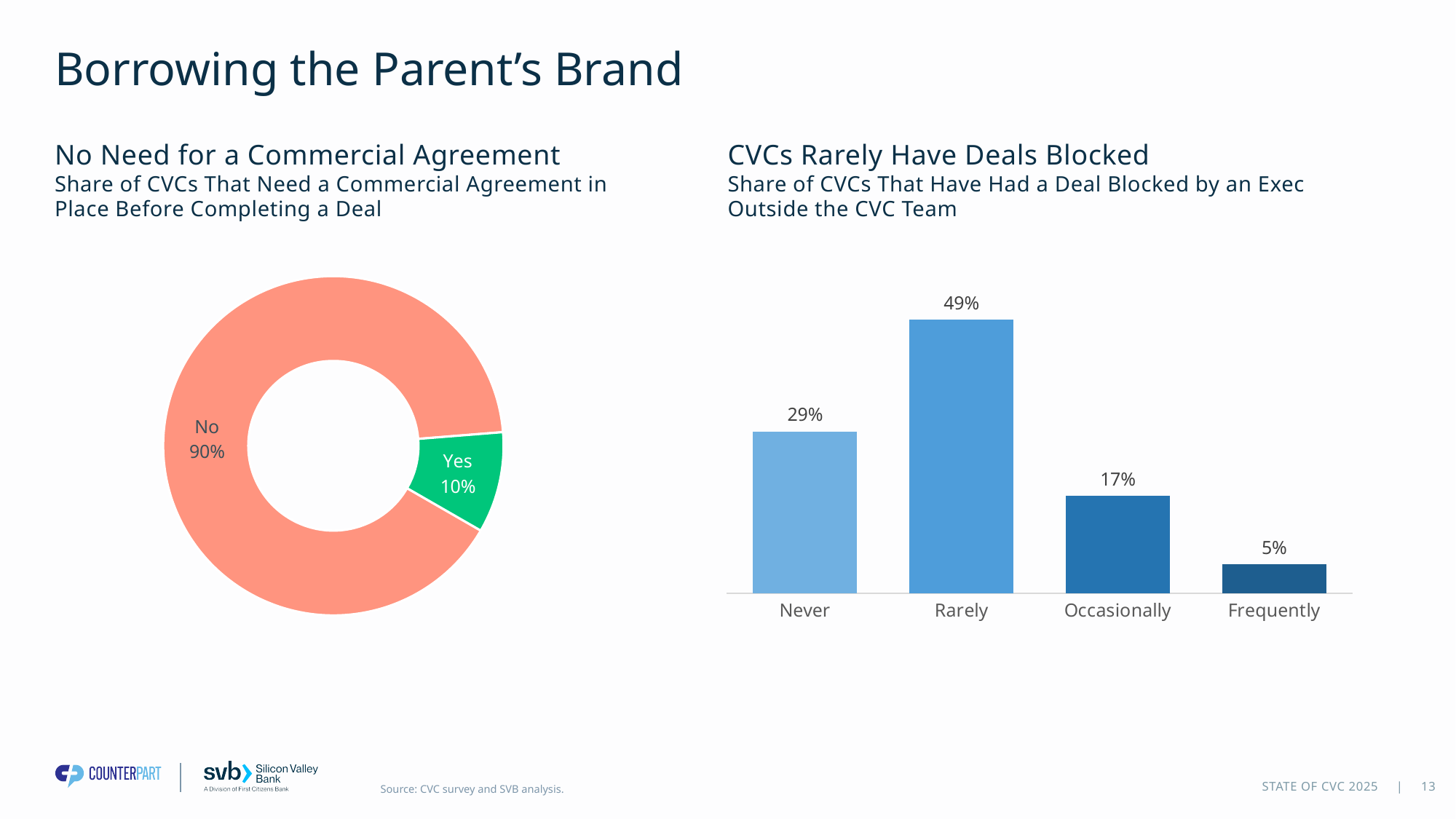
In the 'CVCs Rarely Have Deals Blocked' chart, which category has the lowest value? Frequently What kind of chart is the 'No Need for a Commercial Agreement' chart? Doughnut chart In the 'No Need for a Commercial Agreement' chart, what share of CVCs answered No? 90% In the 'No Need for a Commercial Agreement' chart, what colour is the Yes slice? Green In the 'CVCs Rarely Have Deals Blocked' chart, what is the value for Rarely? 49% In the 'No Need for a Commercial Agreement' chart, what share of CVCs answered Yes? 10% In the 'CVCs Rarely Have Deals Blocked' chart, what is the difference between Rarely and Never? 20% In the 'CVCs Rarely Have Deals Blocked' chart, which is larger, Never or Occasionally? Never In the 'CVCs Rarely Have Deals Blocked' chart, what is the value for Frequently? 5% In the 'No Need for a Commercial Agreement' chart, how many slices are there? 2 In the 'CVCs Rarely Have Deals Blocked' chart, which category has the highest value? Rarely What kind of chart is the 'CVCs Rarely Have Deals Blocked' chart? Bar chart